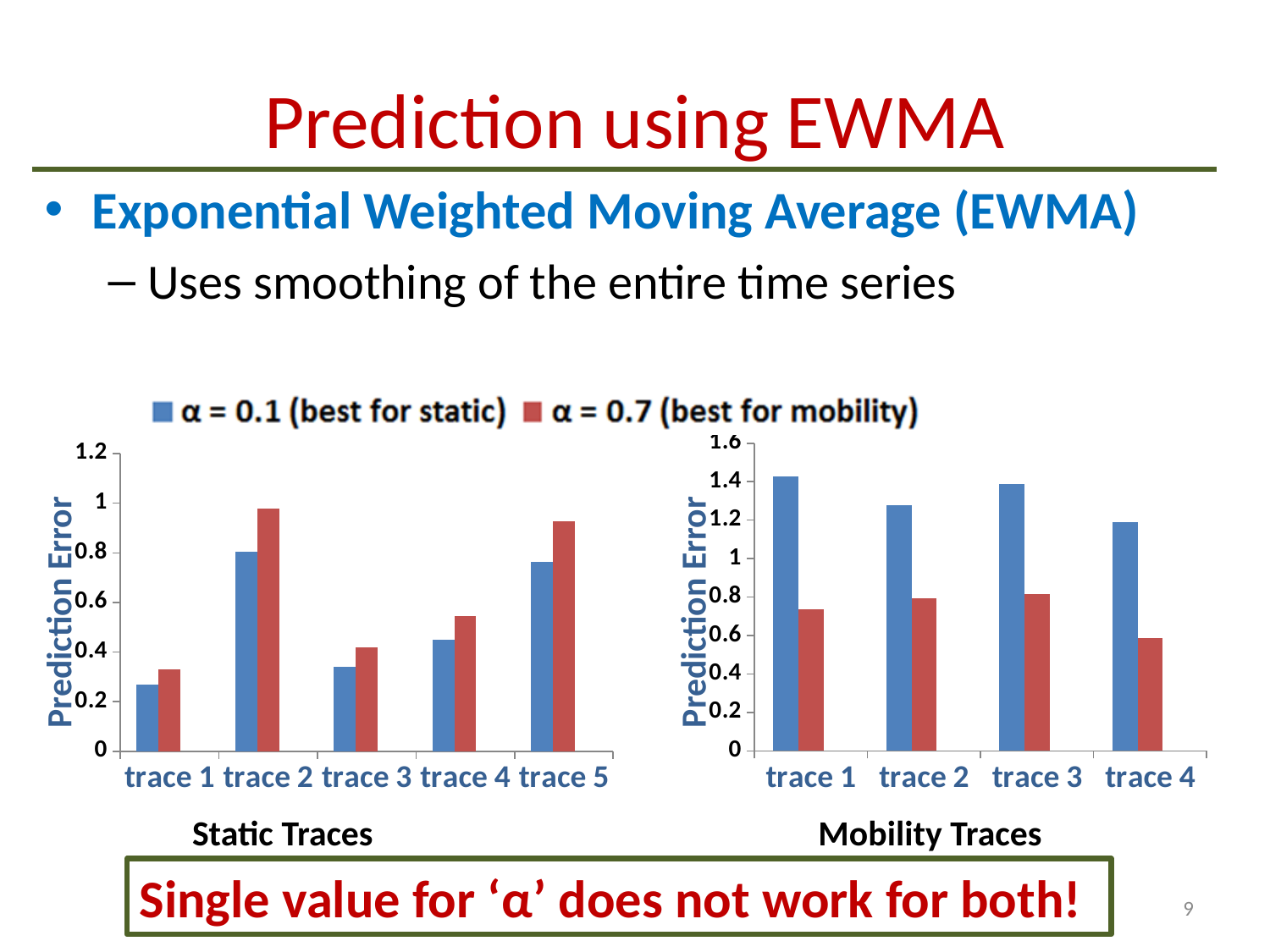
In the Mobility Traces chart, for trace 3, which series has the larger prediction error, α = 0.1 or α = 0.7? α = 0.1 How many traces are shown on the x axis of the Mobility Traces chart? 4 In the Static Traces chart, which trace has the highest prediction error for α = 0.7? trace 2 In the Mobility Traces chart, which trace has the lowest prediction error for α = 0.7? trace 4 How many traces are shown on the x axis of the Static Traces chart? 5 In the Static Traces chart, is the prediction error for trace 2 with α = 0.7 greater or less than 0.8? greater How many series does the legend list? 2 What kind of chart is the Static Traces chart? bar chart In the Mobility Traces chart, which trace has the highest prediction error for α = 0.1? trace 1 What is the y-axis label of the Mobility Traces chart? Prediction Error In the Static Traces chart, which trace has the lowest prediction error for α = 0.1? trace 1